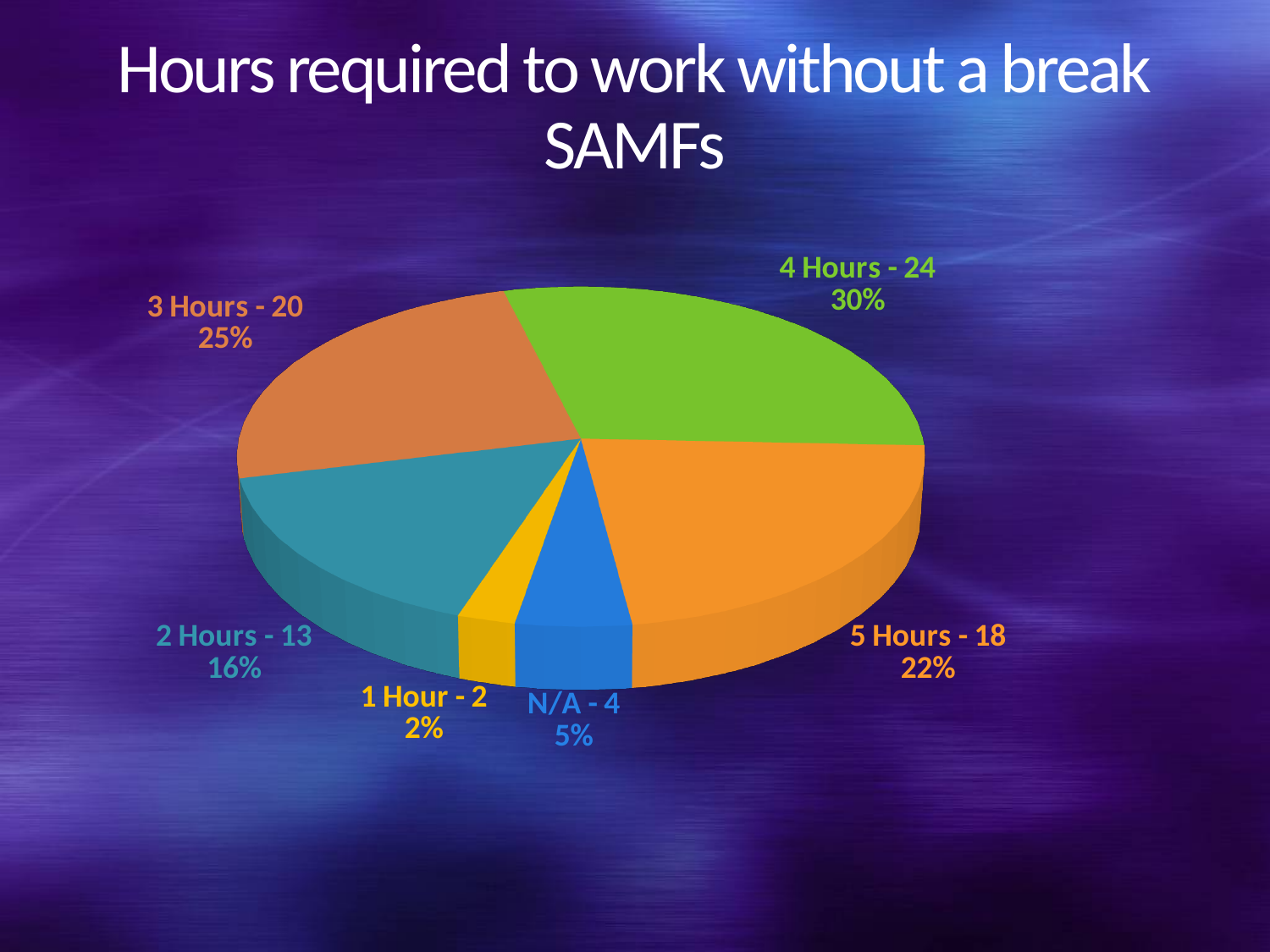
How many slices does the pie chart have? 6 What is the title of the chart? Hours required to work without a break SAMFs Which is larger, the count for 2 Hours or the count for 5 Hours? 5 Hours Which category has the smallest slice? 1 Hour What kind of chart is shown on the slide? Pie chart What is the count for the 4 Hours slice? 24 What is the difference between the counts for 4 Hours and 5 Hours? 6 What is the total count across all slices? 81 What percentage share does the 3 Hours slice have? 25% What is the count for the N/A slice? 4 Which category has the largest slice? 4 Hours What percentage share does the 2 Hours slice have? 16%